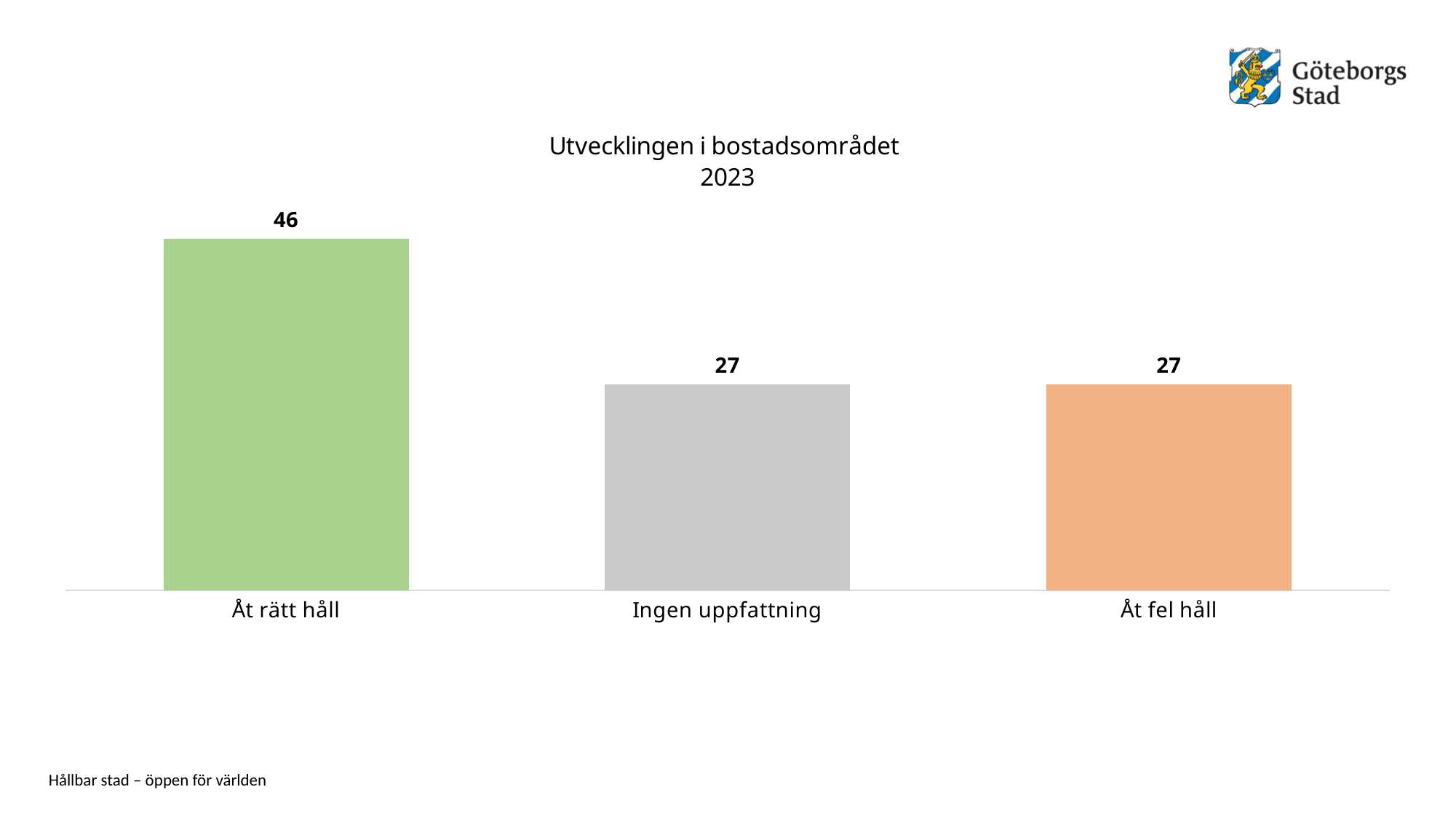
What is the title of the chart? Utvecklingen i bostadsområdet 2023 Which is larger, the value for "Åt rätt håll" or the value for "Ingen uppfattning"? Åt rätt håll What is the value for "Åt fel håll"? 27 What colour is the bar for "Åt rätt håll"? Green What is the total of the three values shown in the chart? 100 What kind of chart is shown on the slide? Bar chart How many categories are shown in the chart? 3 What is the value for "Åt rätt håll"? 46 Do "Ingen uppfattning" and "Åt fel håll" have the same value? Yes Which category has the highest value? Åt rätt håll What is the difference between the values for "Åt rätt håll" and "Åt fel håll"? 19 What is the value for "Ingen uppfattning"? 27